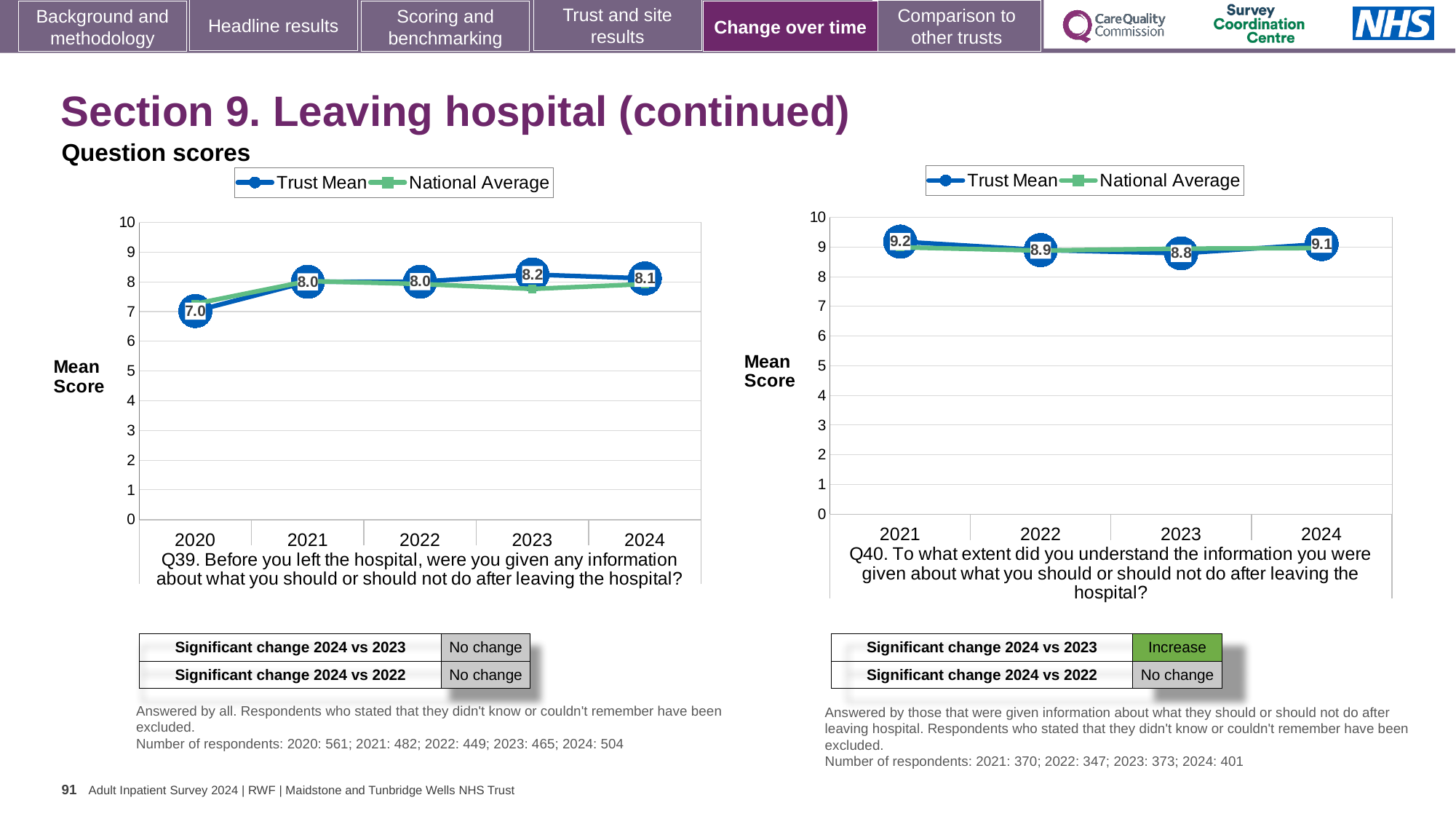
In the Q39 chart on the left, which year has the lowest Trust Mean score? 2020 How many series does the legend of the Q39 chart on the left list? 2 How many years are plotted on the x axis of the Q40 chart on the right? 4 In the Q40 chart on the right, what is the Trust Mean score for 2024? 9.1 In the Q40 chart on the right, what is the difference between the Trust Mean scores for 2021 and 2023? 0.4 In the Q40 chart on the right, is the Trust Mean score for 2022 larger than the score for 2023? Yes What kind of chart is the Q39 chart on the left? Line chart In the Q39 chart on the left, what is the Trust Mean score for 2020? 7.0 In the Q39 chart on the left, what is the Trust Mean score for 2023? 8.2 In the Q40 chart on the right, which year has the highest Trust Mean score? 2021 In the Q39 chart on the left, what is the difference between the Trust Mean scores for 2023 and 2020? 1.2 In the Q39 chart on the left, is the National Average value for 2020 greater or less than 5? greater